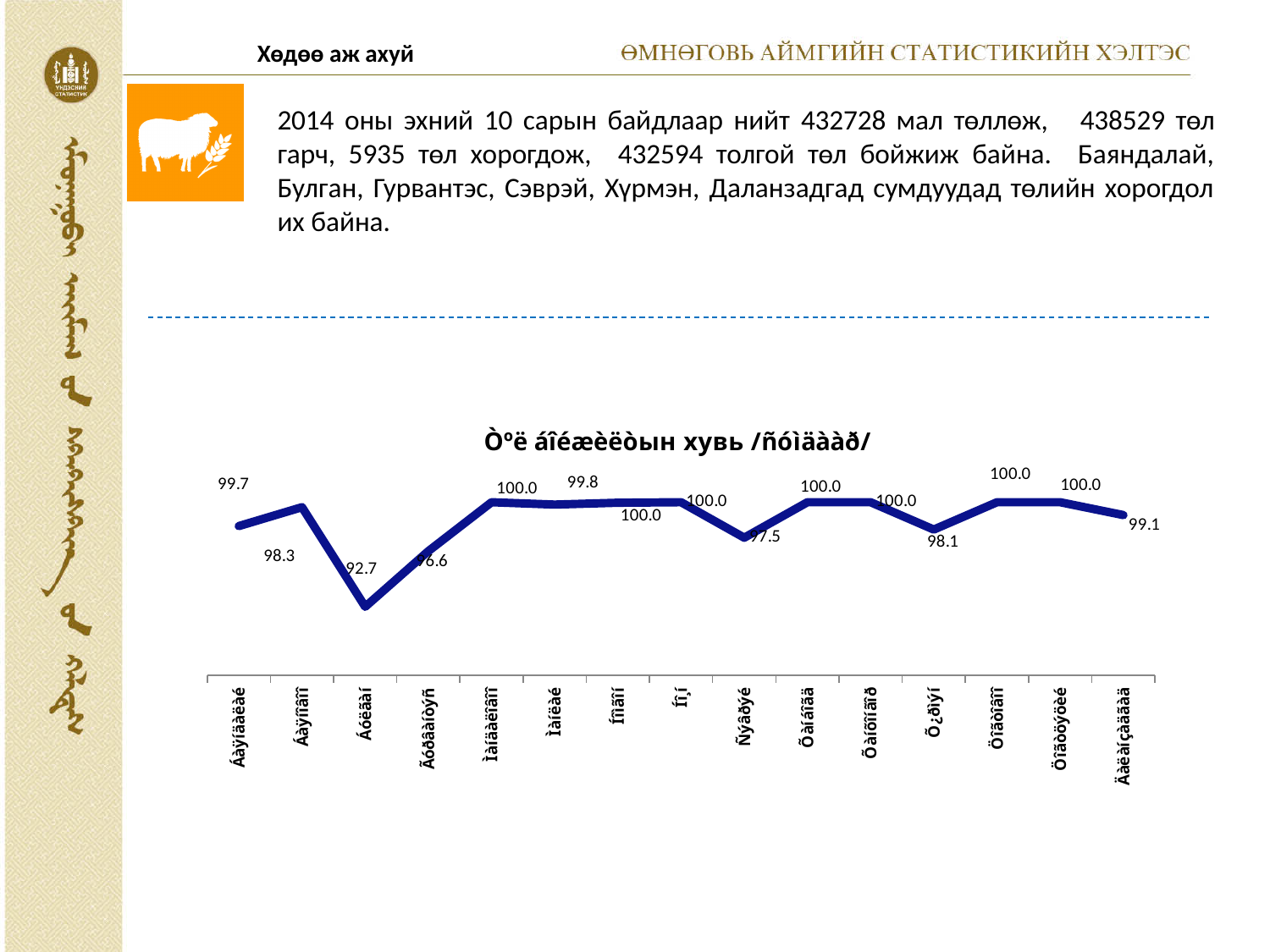
What is the difference between the first point (99.7) and the second point (98.3) on the line chart? 1.4 How many data points are plotted on the line chart? 15 What is the value of the third point from the left on the line chart? 92.7 What is the value of the fourth point from the left on the line chart? 96.6 What is the value of the first (leftmost) point on the line chart? 98.3 What is the lowest value plotted on the line chart? 92.7 What is the difference between the highest value (100.0) and the lowest value (92.7) on the line chart? 7.3 What kind of chart is shown on the slide? line chart Which is larger on the line chart: the value of the ninth point (97.5) or the twelfth point (98.1)? 98.1 What colour is the line on the chart? dark blue Does the line rise or fall between the third point and the fifth point on the line chart? rise What is the value of the last (rightmost) point on the line chart? 99.1